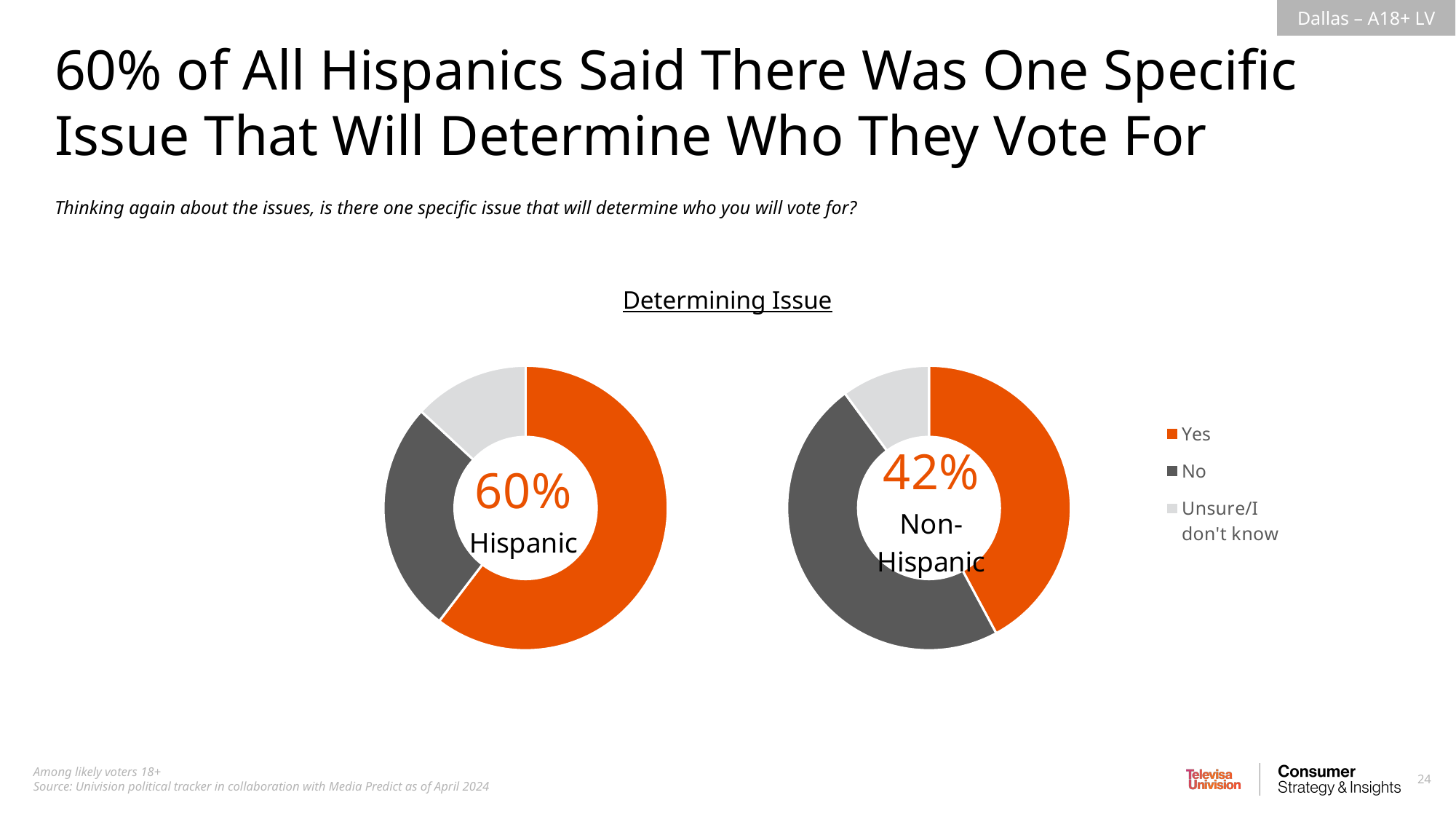
In the Non-Hispanic donut chart, which response is the smallest slice? Unsure/I don't know What is the difference in percentage points between the Hispanic Yes share and the Non-Hispanic Yes share? 18 In the Non-Hispanic donut chart, what percentage said Yes? 42% In the Hispanic donut chart, which response is the largest slice? Yes In the Hispanic donut chart, which response is the smallest slice? Unsure/I don't know How many slices does each donut chart have? 3 Which colour represents the Yes response in the legend? Orange In the Hispanic donut chart, what percentage said Yes? 60% Which group has the larger Yes share, Hispanic or Non-Hispanic? Hispanic How many categories does the legend list for the Determining Issue charts? 3 What kind of chart is used to show the Determining Issue data? Donut (pie) chart What is the title shown above the two donut charts? Determining Issue